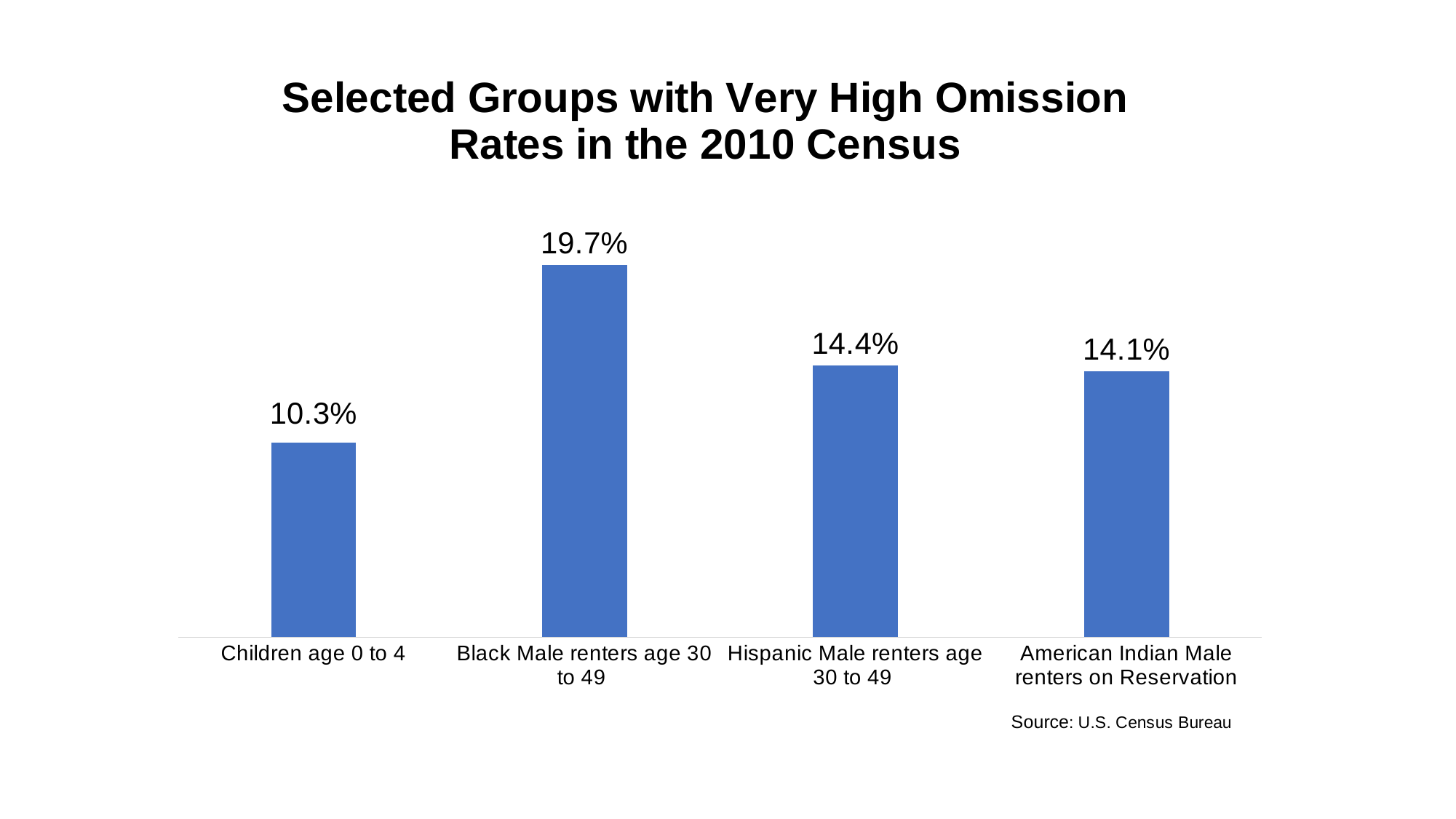
What is the difference between the omission rates for Black Male renters age 30 to 49 and Children age 0 to 4? 9.4% What is the title of the chart? Selected Groups with Very High Omission Rates in the 2010 Census What kind of chart is shown on the slide? Bar chart What is the omission rate for Black Male renters age 30 to 49? 19.7% What is the omission rate for American Indian Male renters on Reservation? 14.1% How many groups are shown in the chart? 4 What is the difference between the omission rates for Hispanic Male renters age 30 to 49 and American Indian Male renters on Reservation? 0.3% Which group has the lowest omission rate? Children age 0 to 4 Which group has the highest omission rate? Black Male renters age 30 to 49 What is the omission rate for Children age 0 to 4? 10.3% Which has a higher omission rate: Children age 0 to 4 or Hispanic Male renters age 30 to 49? Hispanic Male renters age 30 to 49 What is the omission rate for Hispanic Male renters age 30 to 49? 14.4%